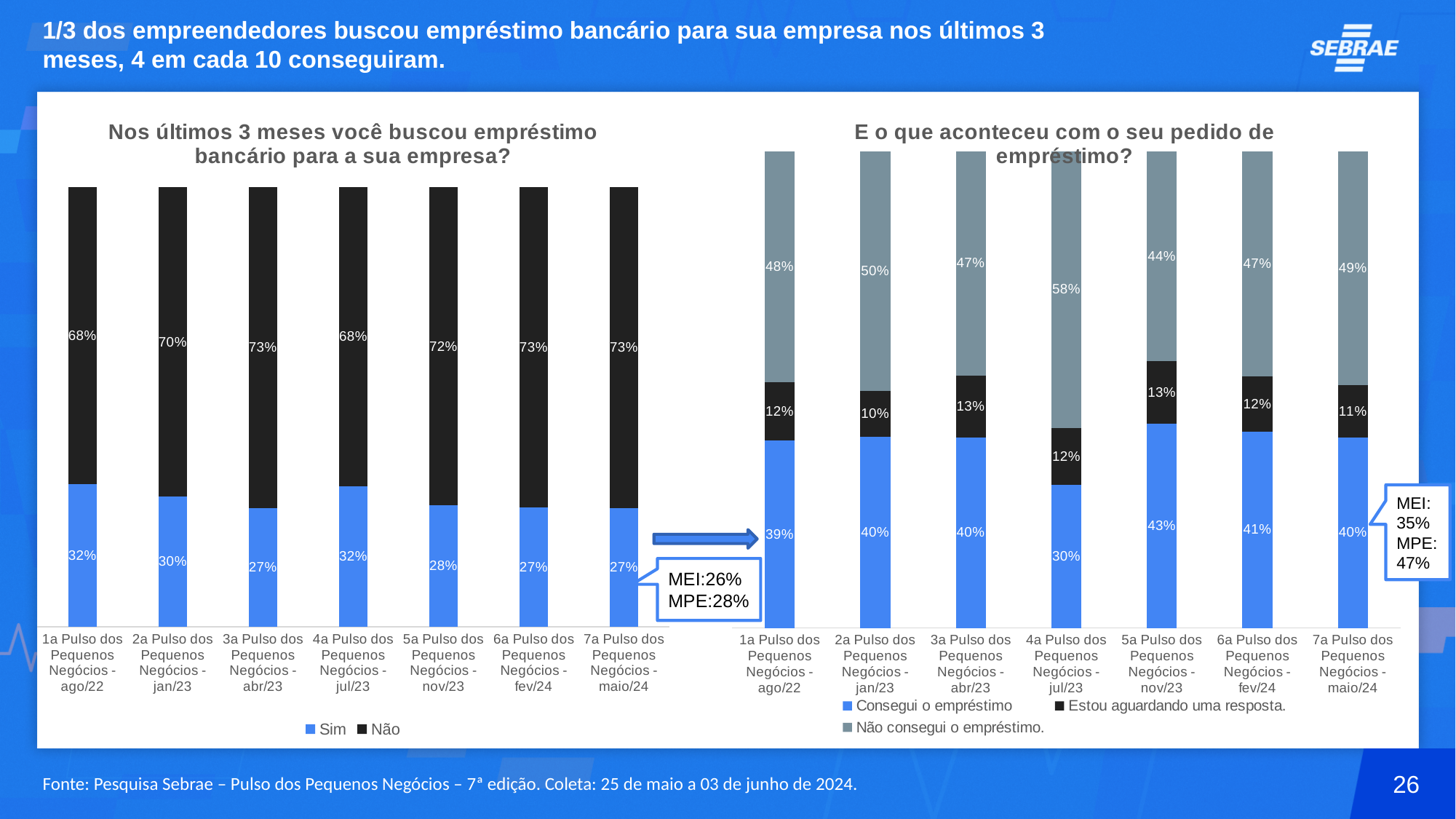
In the right chart 'E o que aconteceu com o seu pedido de empréstimo?', is the 'Consegui o empréstimo' value larger for 5a Pulso (nov/23) or 4a Pulso (jul/23)? 5a Pulso (nov/23) In the left chart 'Nos últimos 3 meses você buscou empréstimo bancário para a sua empresa?', what is the 'Sim' value for 1a Pulso dos Pequenos Negócios - ago/22? 32% In the right chart 'E o que aconteceu com o seu pedido de empréstimo?', which survey wave has the lowest 'Consegui o empréstimo' value? 4a Pulso dos Pequenos Negócios - jul/23 In the left chart 'Nos últimos 3 meses você buscou empréstimo bancário para a sua empresa?', how many series does the legend list? 2 In the right chart 'E o que aconteceu com o seu pedido de empréstimo?', what is the 'Consegui o empréstimo' value for 5a Pulso dos Pequenos Negócios - nov/23? 43% In the left chart 'Nos últimos 3 meses você buscou empréstimo bancário para a sua empresa?', what is the 'Não' value for 7a Pulso dos Pequenos Negócios - maio/24? 73% What kind of chart is the right chart 'E o que aconteceu com o seu pedido de empréstimo?'? Stacked bar chart In the left chart 'Nos últimos 3 meses você buscou empréstimo bancário para a sua empresa?', what is the difference between the 'Sim' values for 1a Pulso (ago/22) and 7a Pulso (maio/24)? 5% In the right chart 'E o que aconteceu com o seu pedido de empréstimo?', which survey wave has the highest 'Não consegui o empréstimo' value? 4a Pulso dos Pequenos Negócios - jul/23 In the right chart 'E o que aconteceu com o seu pedido de empréstimo?', how many survey waves are shown on the x axis? 7 In the right chart 'E o que aconteceu com o seu pedido de empréstimo?', what is the 'Estou aguardando uma resposta' value for 2a Pulso dos Pequenos Negócios - jan/23? 10% In the left chart 'Nos últimos 3 meses você buscou empréstimo bancário para a sua empresa?', which survey wave has the highest 'Não' value among the first five waves (ago/22 to nov/23)? 3a Pulso dos Pequenos Negócios - abr/23